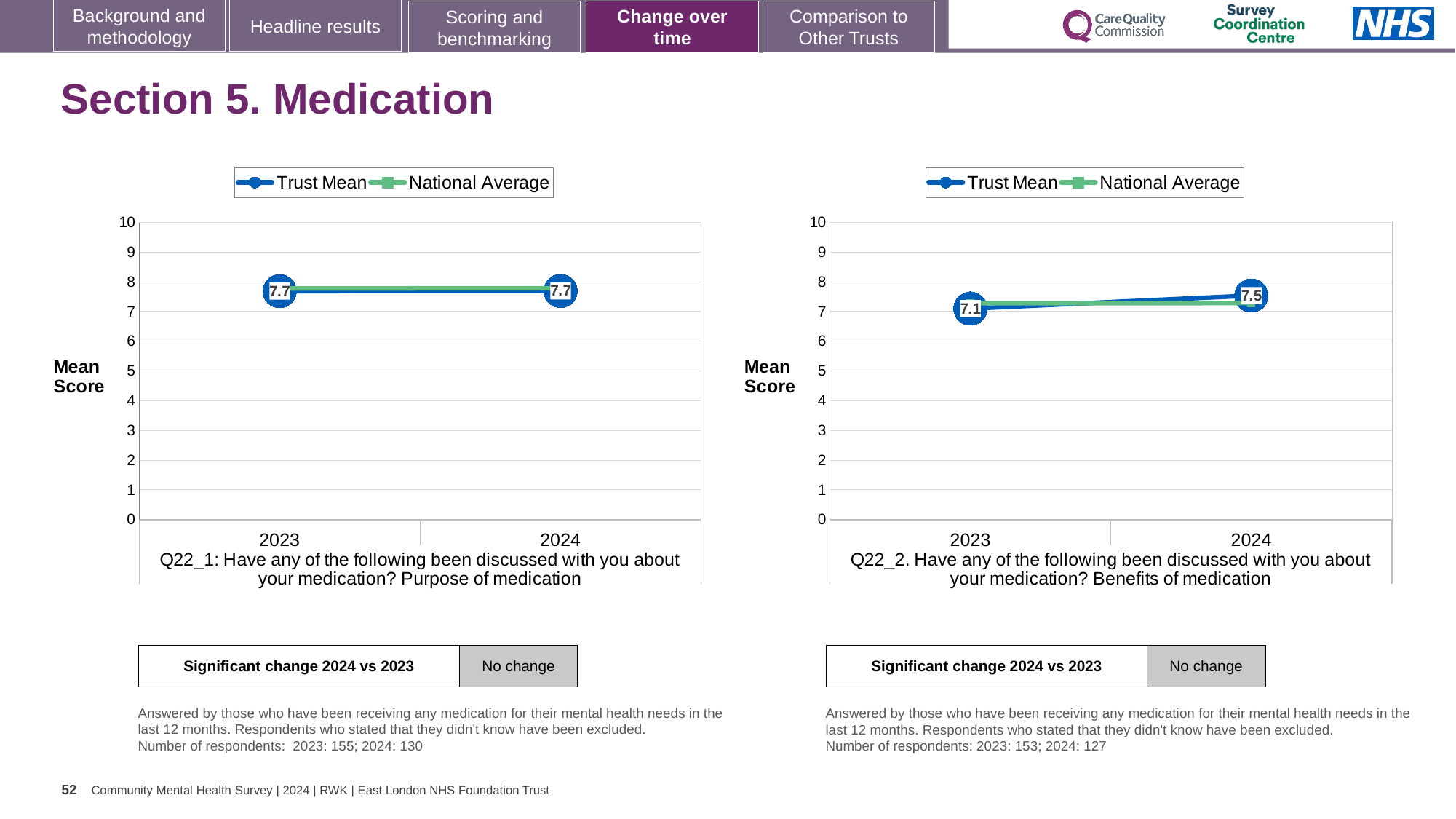
In the Q22_1 chart (left), does the Trust Mean rise, fall or stay the same from 2023 to 2024? stay the same How many series does the legend of the Q22_2 chart (right) list? 2 In the Q22_2 chart (right), does the Trust Mean rise or fall from 2023 to 2024? rise In the Q22_2 chart (right), is the Trust Mean higher in 2023 or 2024? 2024 In the Q22_1 chart (left), what is the Trust Mean for 2024? 7.7 What kind of chart is the Q22_1 chart (left)? line chart In the Q22_2 chart (right), by how much did the Trust Mean change from 2023 to 2024? 0.4 In the Q22_1 chart (left), is the National Average for 2024 greater or less than 5? greater How many years are shown on the x axis of the Q22_1 chart (left)? 2 In the Q22_2 chart (right), what is the Trust Mean for 2023? 7.1 In the Q22_2 chart (right), what is the Trust Mean for 2024? 7.5 In the Q22_1 chart (left), what is the Trust Mean for 2023? 7.7